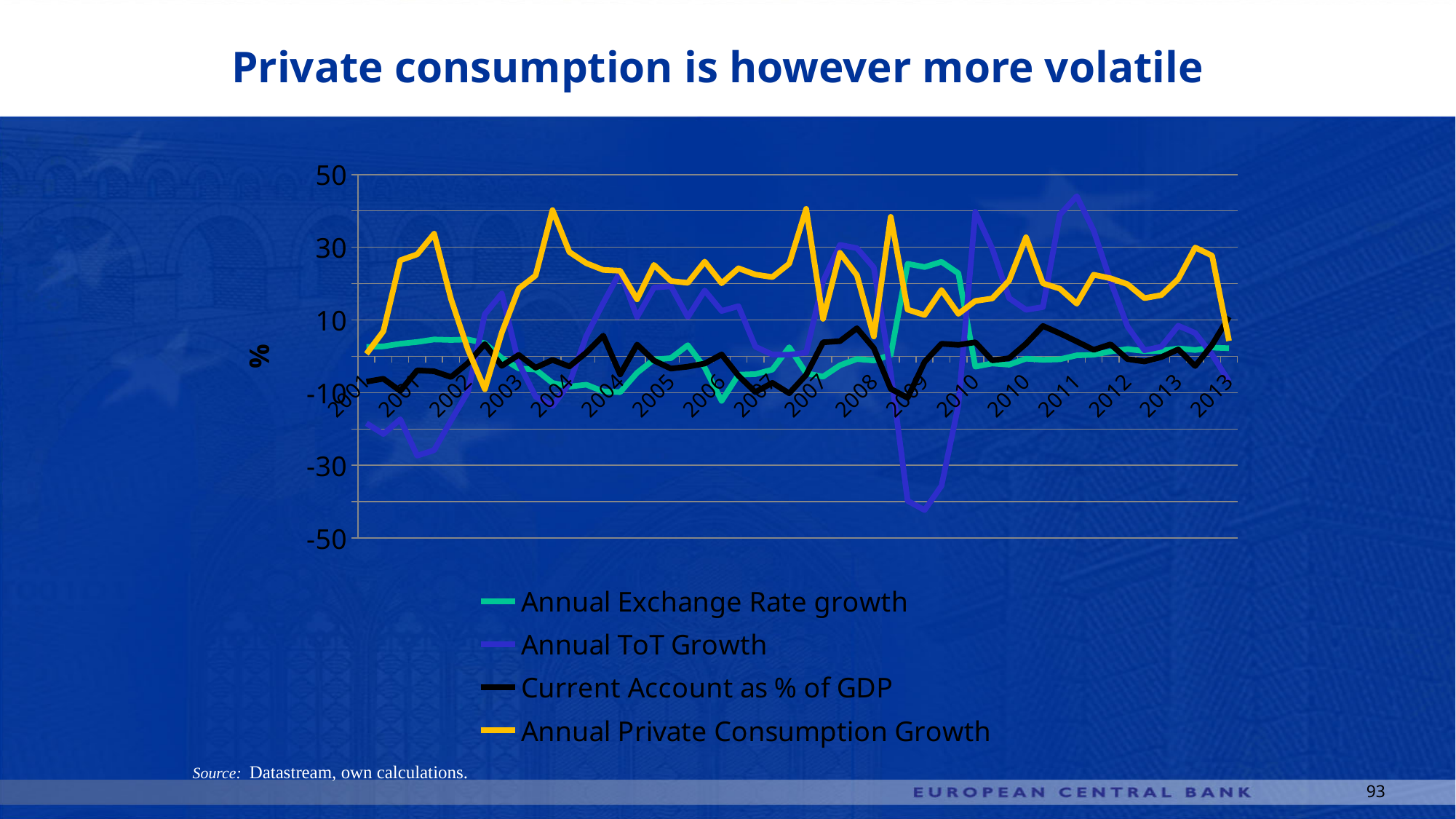
Is the value for Annual ToT Growth at its peak around 2011 greater or less than 30? greater Is the value for Annual Exchange Rate growth at its peak around 2009 greater or less than 10? greater Which series is drawn in yellow? Annual Private Consumption Growth What is the title of the slide? Private consumption is however more volatile Which series reaches the lowest value on the chart? Annual ToT Growth What kind of chart is shown on the slide? line chart How many series does the legend list? 4 Is the value for Annual Private Consumption Growth at its peak around 2004 greater or less than 30? greater What is the maximum value shown on the y axis? 50 Around 2009, which is larger: Annual Exchange Rate growth or Annual ToT Growth? Annual Exchange Rate growth How many year labels are shown along the x axis? 18